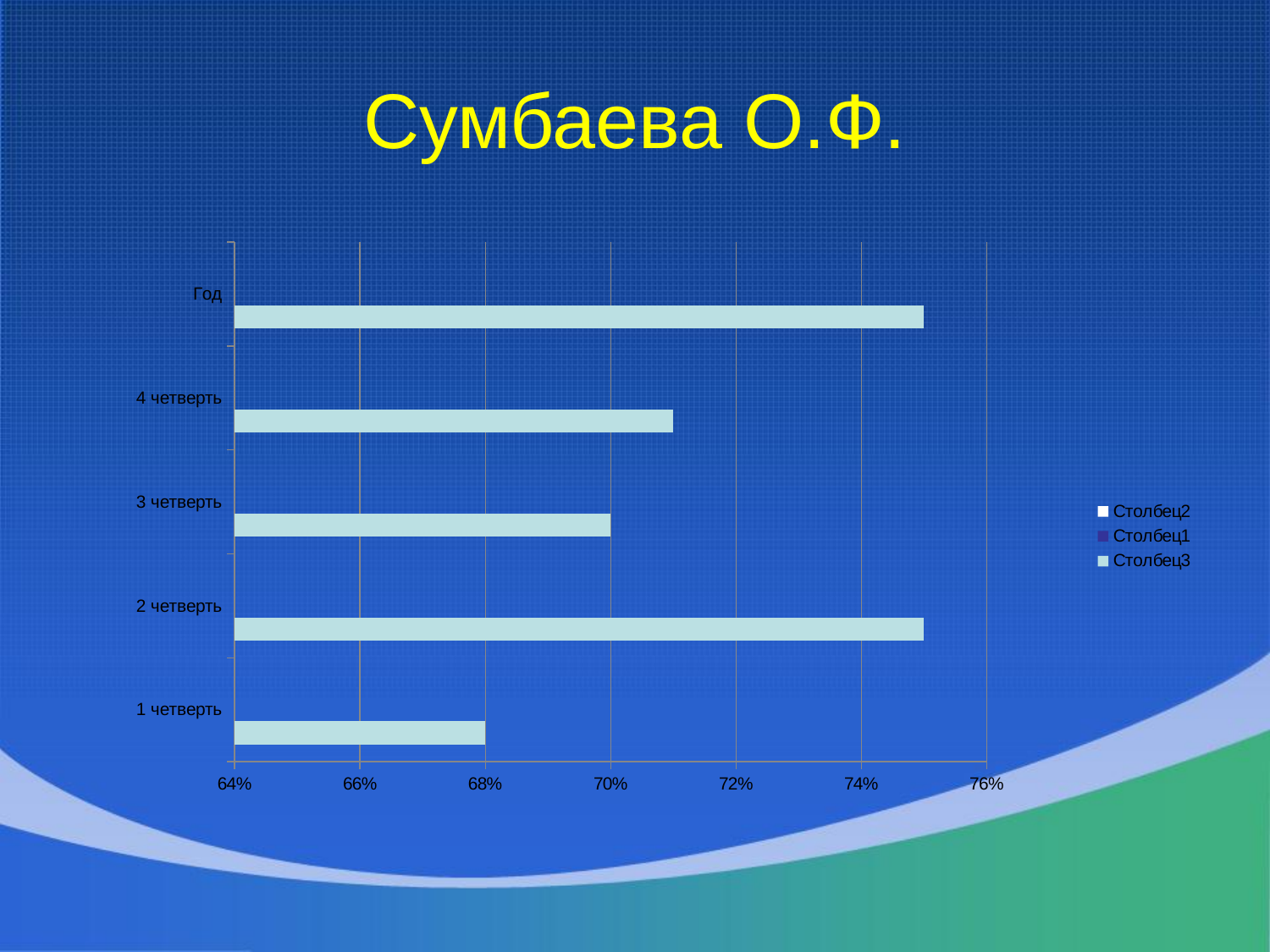
Is the value for 4 четверть greater or less than 72%? less Which is larger, the value for 2 четверть or the value for 1 четверть? 2 четверть What is the value for 1 четверть? 68% Which is larger, the value for Год or the value for 4 четверть? Год Which category has the lowest value? 1 четверть How many categories are shown on the chart? 5 Is the value for 2 четверть greater or less than 74%? greater What is the value for 3 четверть? 70% Is the value for Год greater or less than 74%? greater How many series does the legend list? 3 What is the title of the slide? Сумбаева О.Ф. What type of chart is shown on the slide? bar chart